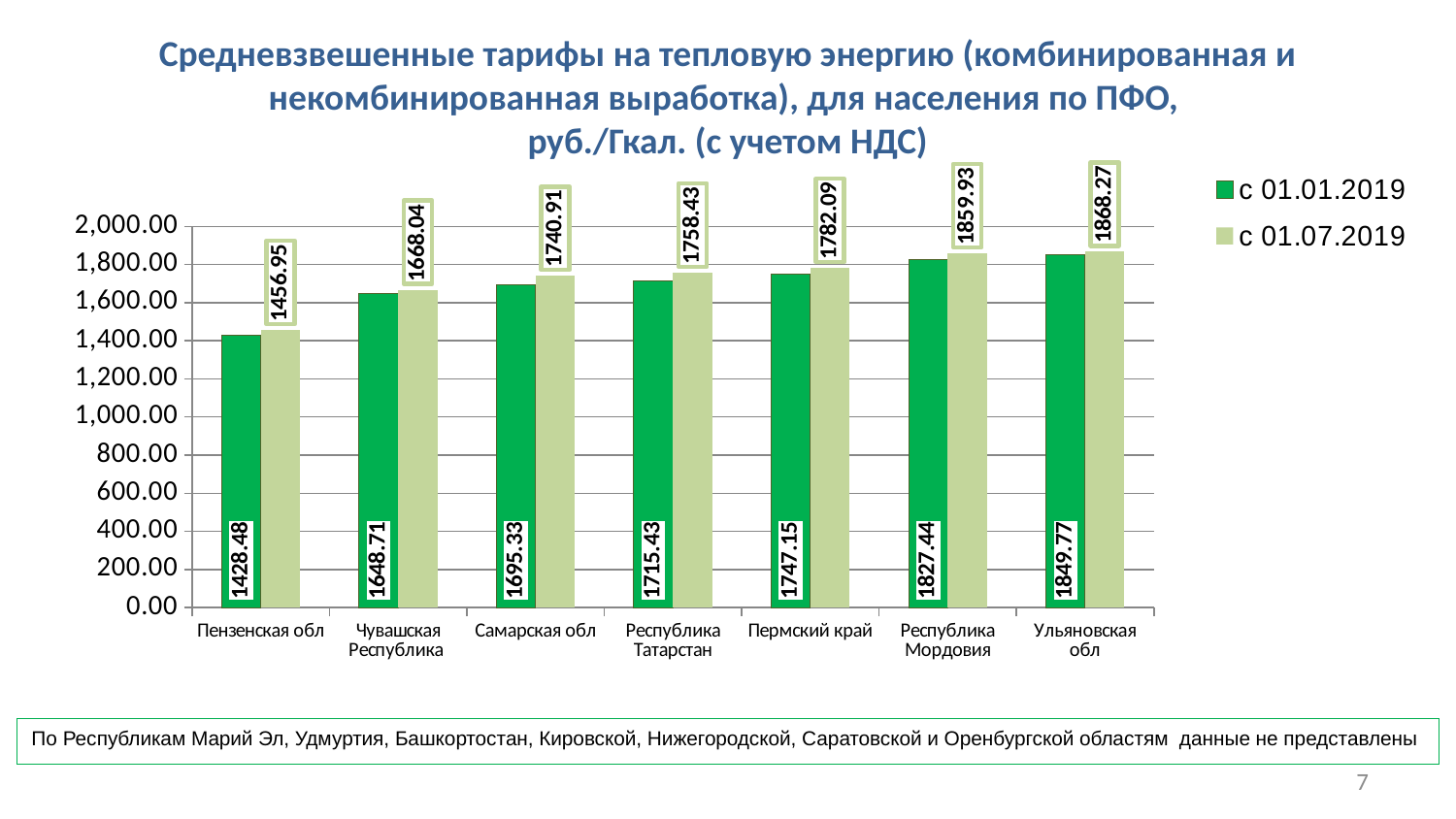
Which is larger: the с 01.01.2019 value for Пермский край or the с 01.01.2019 value for Республика Татарстан? Пермский край What is the value for Республика Мордовия in the series с 01.07.2019? 1859.93 How many series does the legend list? 2 What kind of chart is shown on the slide? Bar chart Which region has the highest value in the series с 01.07.2019? Ульяновская обл Do the с 01.01.2019 values rise or fall from left to right along the x axis? Rise Which series is shown in the darker green colour? с 01.01.2019 What is the difference between the с 01.07.2019 and с 01.01.2019 values for Ульяновская обл? 18.50 Which region has the lowest value in the series с 01.01.2019? Пензенская обл What is the value for Самарская обл in the series с 01.07.2019? 1740.91 What is the value for Пензенская обл in the series с 01.01.2019? 1428.48 How many regions (categories) are plotted on the x axis? 7